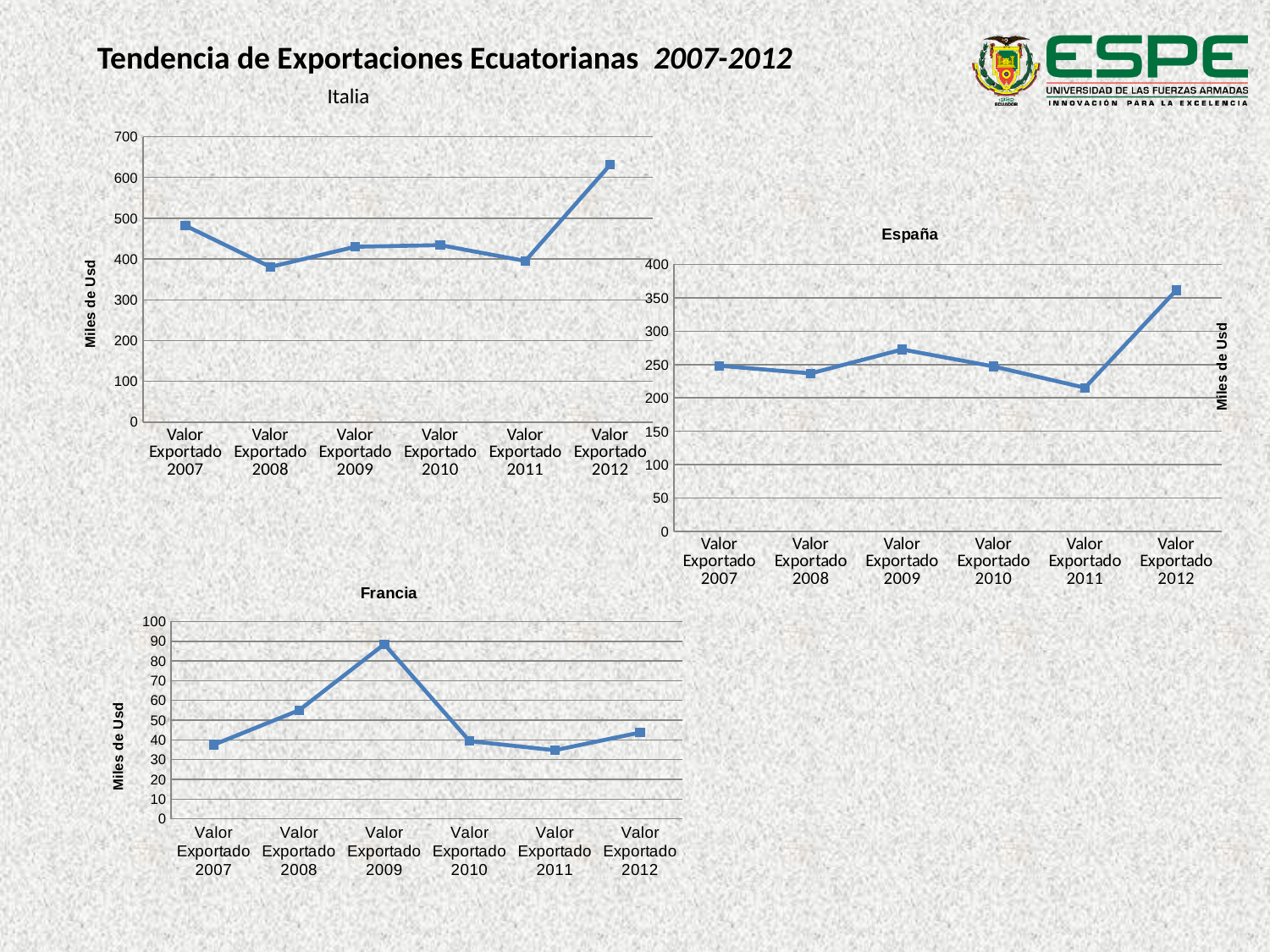
In the Italia chart, which year has the highest exported value? 2012 How many data points are plotted in the Francia chart? 6 In the Italia chart, which is larger, the value for 2007 or the value for 2011? 2007 In the España chart, is the value for 2011 greater or less than 250? less In the Francia chart, which year has the highest exported value? 2009 What is the y-axis label of the España chart? Miles de Usd In the Francia chart, is the value for 2009 greater or less than 80? greater What kind of chart is the Italia chart? line chart In the España chart, which year has the lowest exported value? 2011 In the Italia chart, which year has the lowest exported value? 2008 In the España chart, which year has the highest exported value? 2012 In the Italia chart, is the value for 2012 greater or less than 600? greater